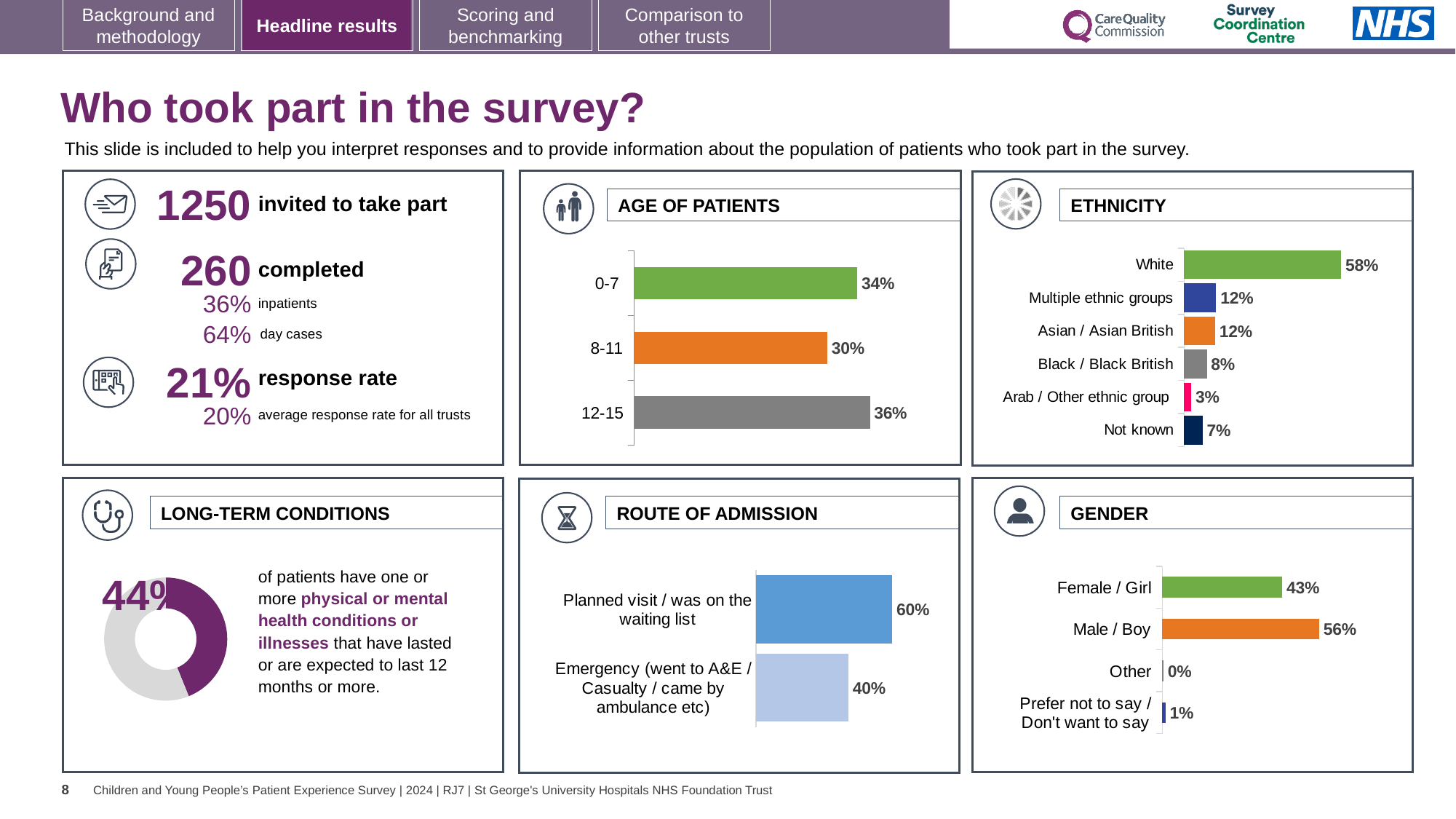
In the ETHNICITY chart, what is the difference between the White and Black / Black British percentages? 50% In the AGE OF PATIENTS chart, which age group has the highest percentage? 12-15 What kind of chart is used in the LONG-TERM CONDITIONS panel? Doughnut chart In the GENDER chart, what percentage of patients answered Prefer not to say / Don't want to say? 1% In the LONG-TERM CONDITIONS panel, what percentage of patients have one or more physical or mental health conditions or illnesses? 44% In the ROUTE OF ADMISSION chart, what is the difference between the planned visit and emergency percentages? 20% In the ETHNICITY chart, how many ethnicity categories are shown? 6 In the ROUTE OF ADMISSION chart, what percentage of patients had a planned visit / were on the waiting list? 60% In the GENDER chart, which is larger, Female / Girl or Male / Boy? Male / Boy In the ETHNICITY chart, which ethnic group has the lowest percentage? Arab / Other ethnic group In the AGE OF PATIENTS chart, what percentage of patients were aged 8-11? 30% In the ETHNICITY chart, what percentage of patients were White? 58%